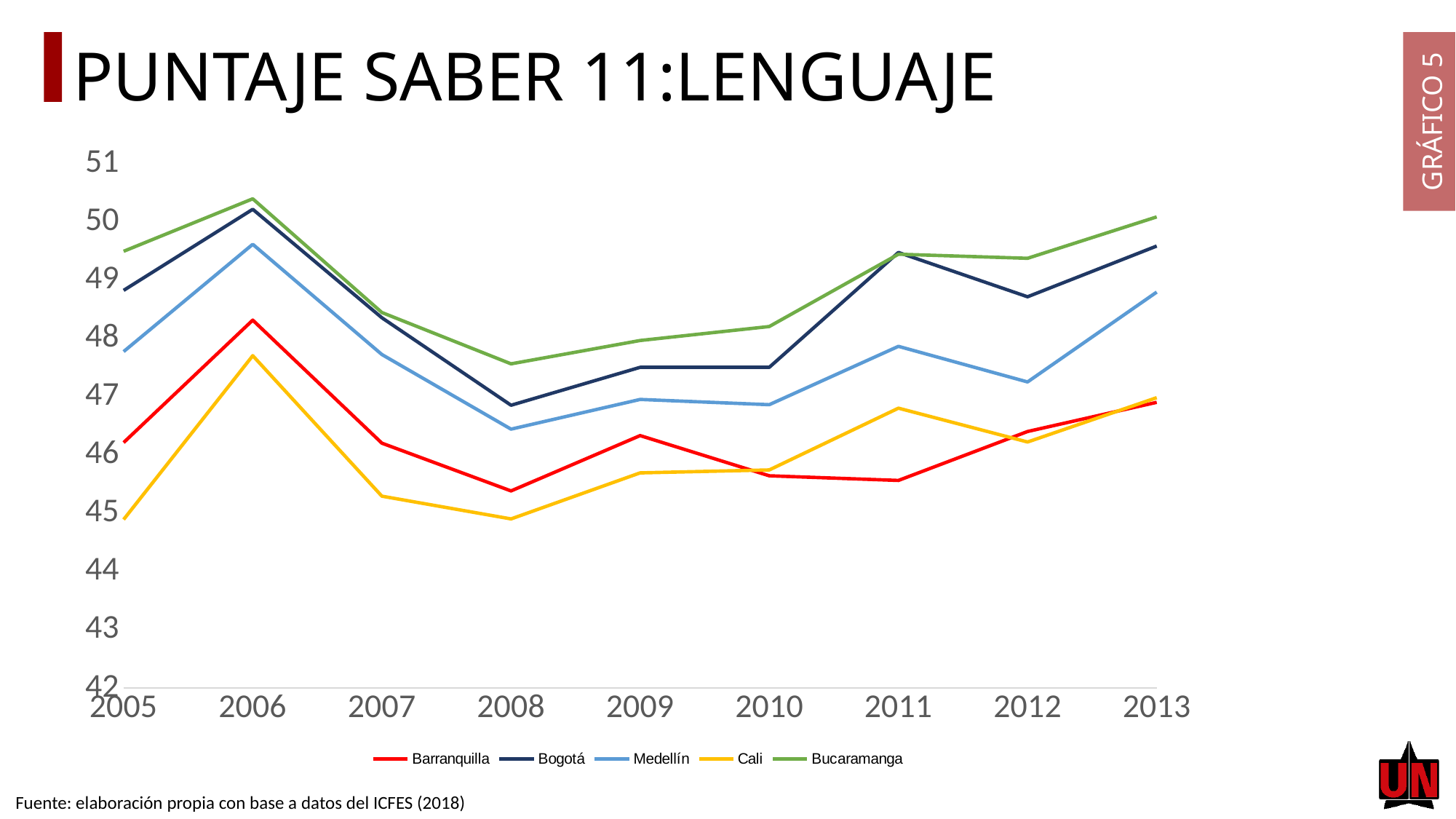
In which year does Bucaramanga reach its highest score? 2006 Is the value for Bogotá in 2012 greater or less than 49? less How many years are shown on the x axis? 9 What kind of chart is shown on the slide? line chart Does the Bucaramanga line rise or fall from 2008 to 2013? rise What is the title of the chart? PUNTAJE SABER 11:LENGUAJE How many series does the legend list? 5 Which city has the highest score in 2013? Bucaramanga Is the value for Barranquilla in 2006 greater or less than 48? greater In 2006, which is higher, Bogotá or Medellín? Bogotá Which city has the lowest score in 2008? Cali Which city is represented by the yellow line? Cali